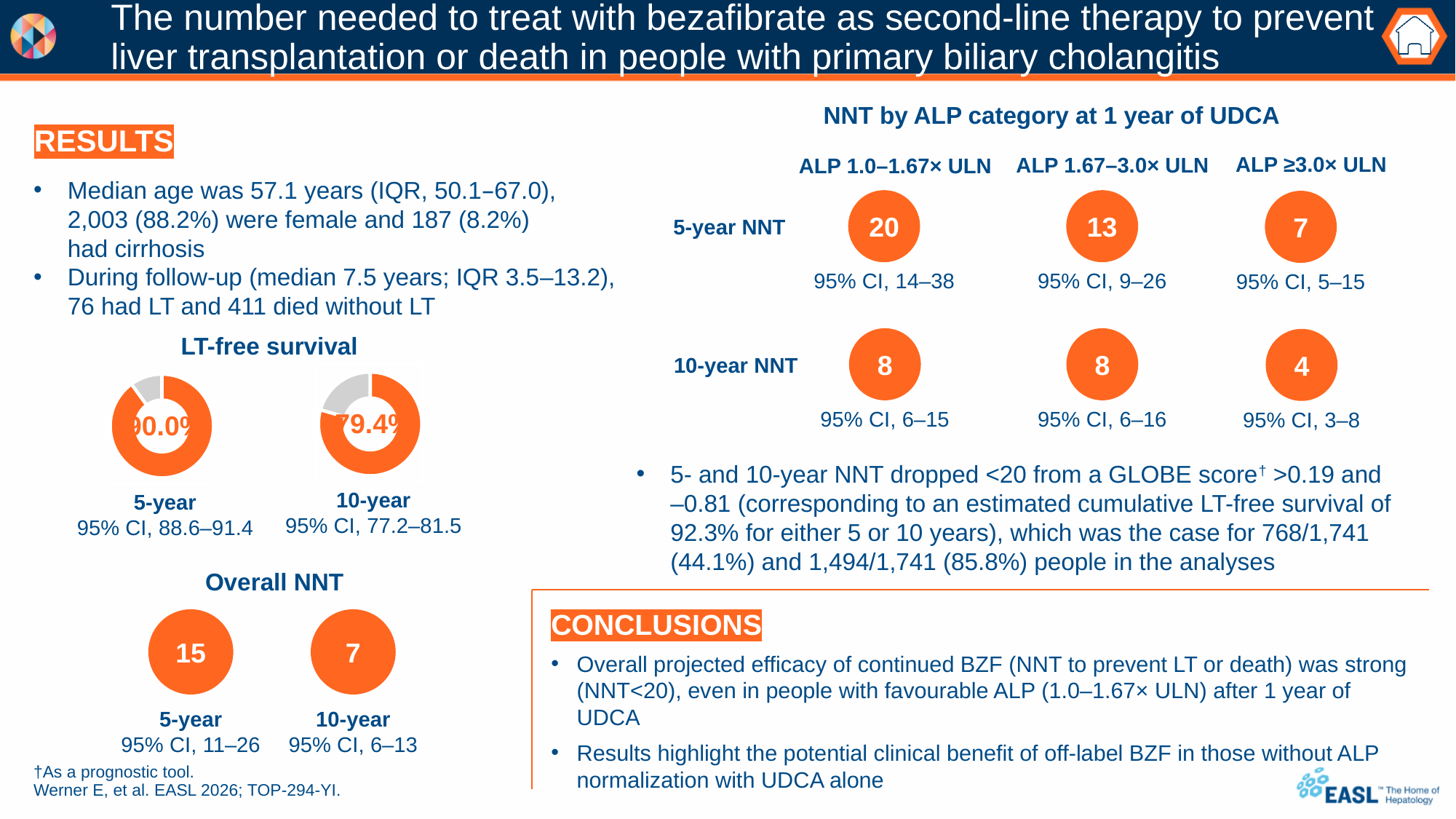
In the 'NNT by ALP category at 1 year of UDCA' graphic, which ALP category has the highest 5-year NNT? ALP 1.0–1.67× ULN In the LT-free survival charts, what is the 10-year LT-free survival value? 79.4% In the LT-free survival charts, what is the difference between the 5-year and 10-year survival values? 10.6 percentage points What kind of chart is used to show LT-free survival on the slide? doughnut chart In the LT-free survival charts, which is larger, the 5-year or the 10-year survival value? 5-year In the LT-free survival charts, what colour is the filled (survival) portion of each ring? orange In the LT-free survival charts, is the 10-year survival value greater or less than 80%? less In the LT-free survival charts, what is the 5-year LT-free survival value? 90.0% How many LT-free survival pie charts are shown on the slide? 2 In the LT-free survival charts, what is the 95% CI shown under the 5-year chart? 95% CI, 88.6–91.4 In the LT-free survival charts, does the survival value rise or fall from 5-year to 10-year? fall In the 'NNT by ALP category at 1 year of UDCA' graphic, what is the 5-year NNT for ALP ≥3.0× ULN? 7